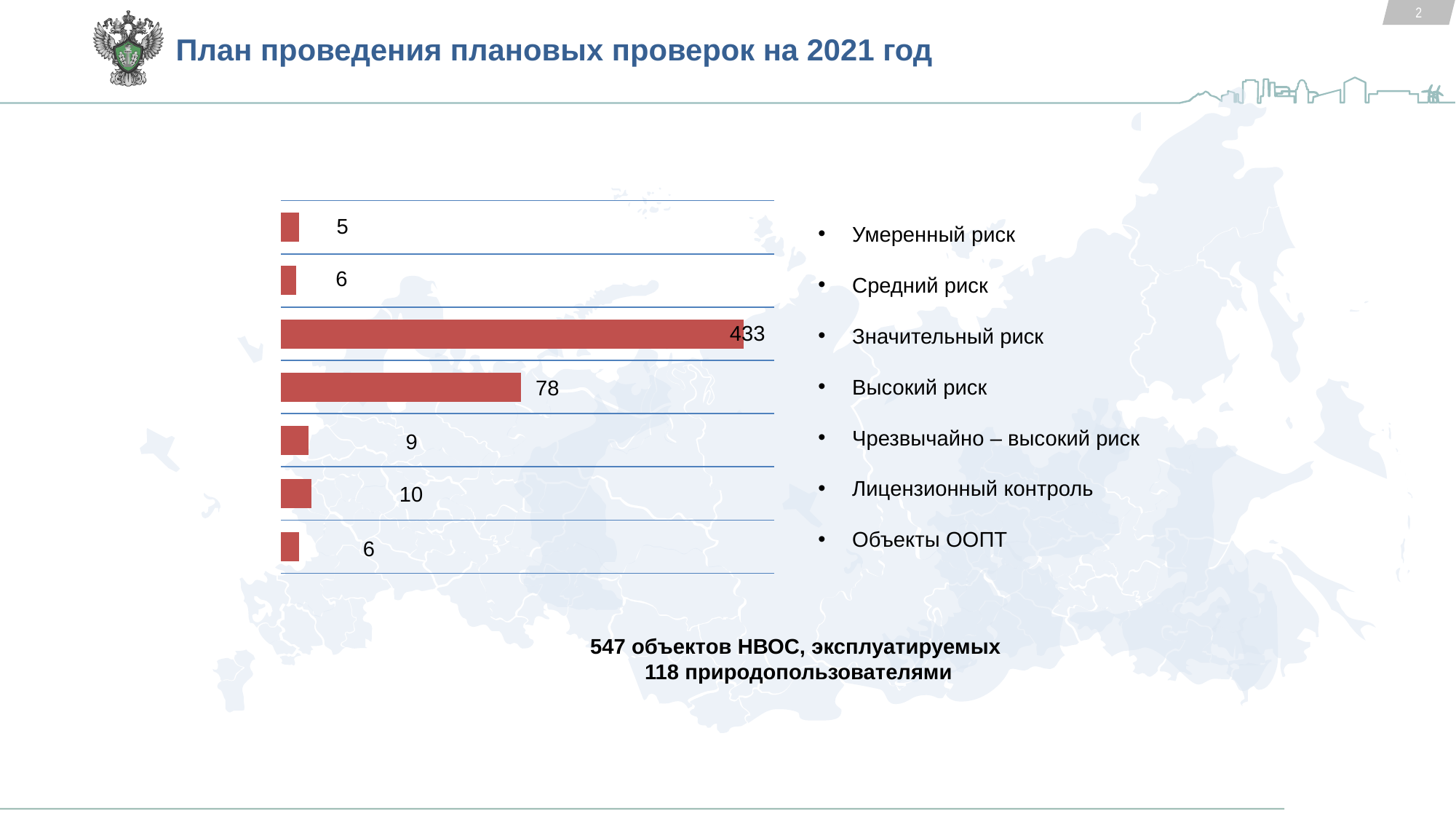
Which category has the lowest value? Умеренный риск What is the sum of all the values shown in the chart? 547 What is the value for Лицензионный контроль? 10 What is the value for Значительный риск? 433 Which category has the highest value? Значительный риск What is the value for Умеренный риск? 5 What is the value for Высокий риск? 78 What is the difference between the values for Значительный риск and Высокий риск? 355 How many bars (categories) does the chart show? 7 What is the title of the slide containing the chart? План проведения плановых проверок на 2021 год What type of chart is shown on the slide? Bar chart Which is larger, the value for Лицензионный контроль or the value for Чрезвычайно – высокий риск? Лицензионный контроль